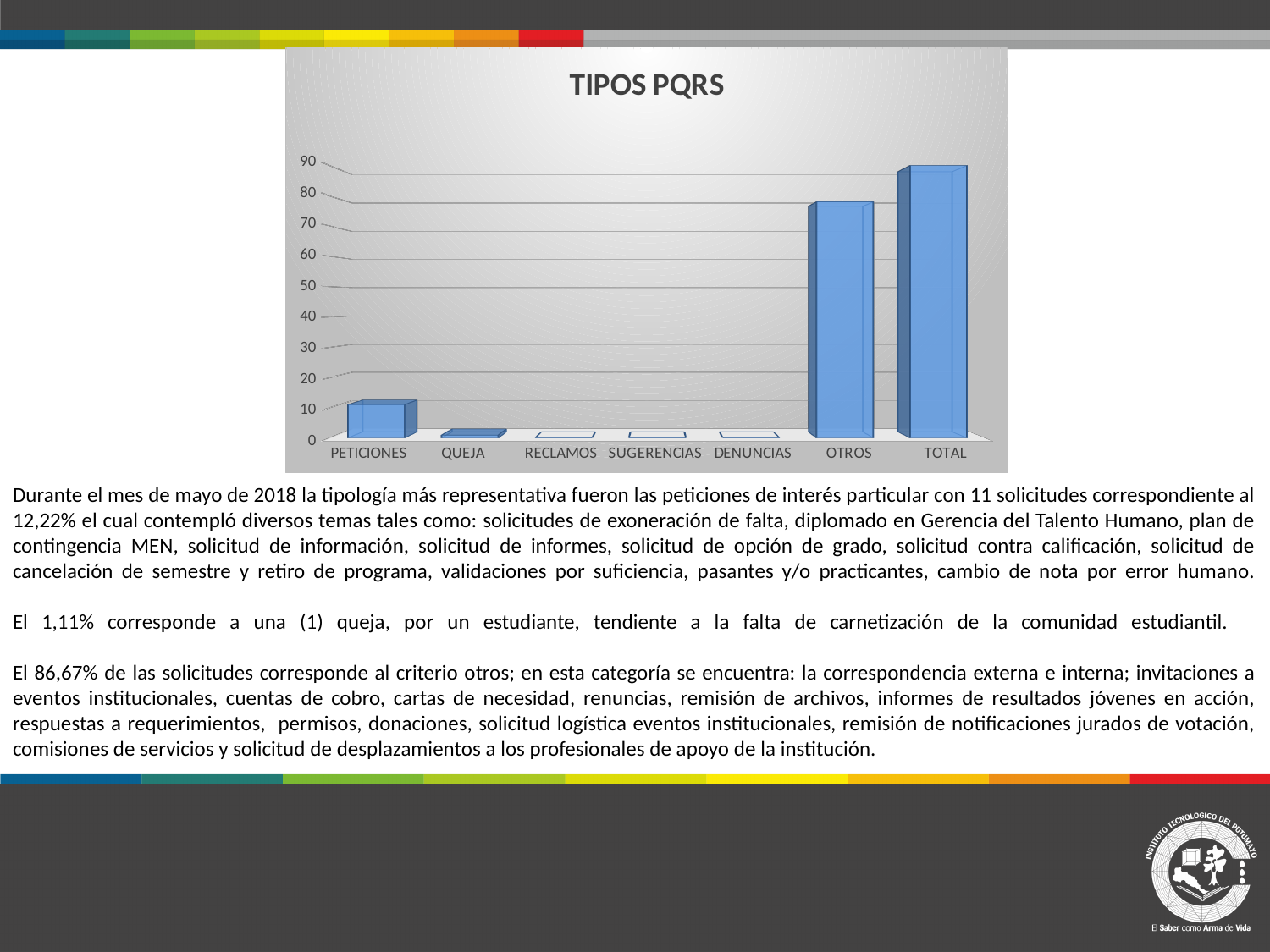
Is the value for PETICIONES greater or less than 20? less Which category has the highest bar in the chart? TOTAL What kind of chart is shown on the slide? bar chart Is the value for TOTAL greater or less than 80? greater Which is larger, the value for OTROS or the value for PETICIONES? OTROS Which is larger, the value for TOTAL or the value for OTROS? TOTAL Is the value for QUEJA greater or less than 10? less What colour are the bars in the chart? blue What is the title of the chart? TIPOS PQRS How many categories are shown on the x axis of the chart? 7